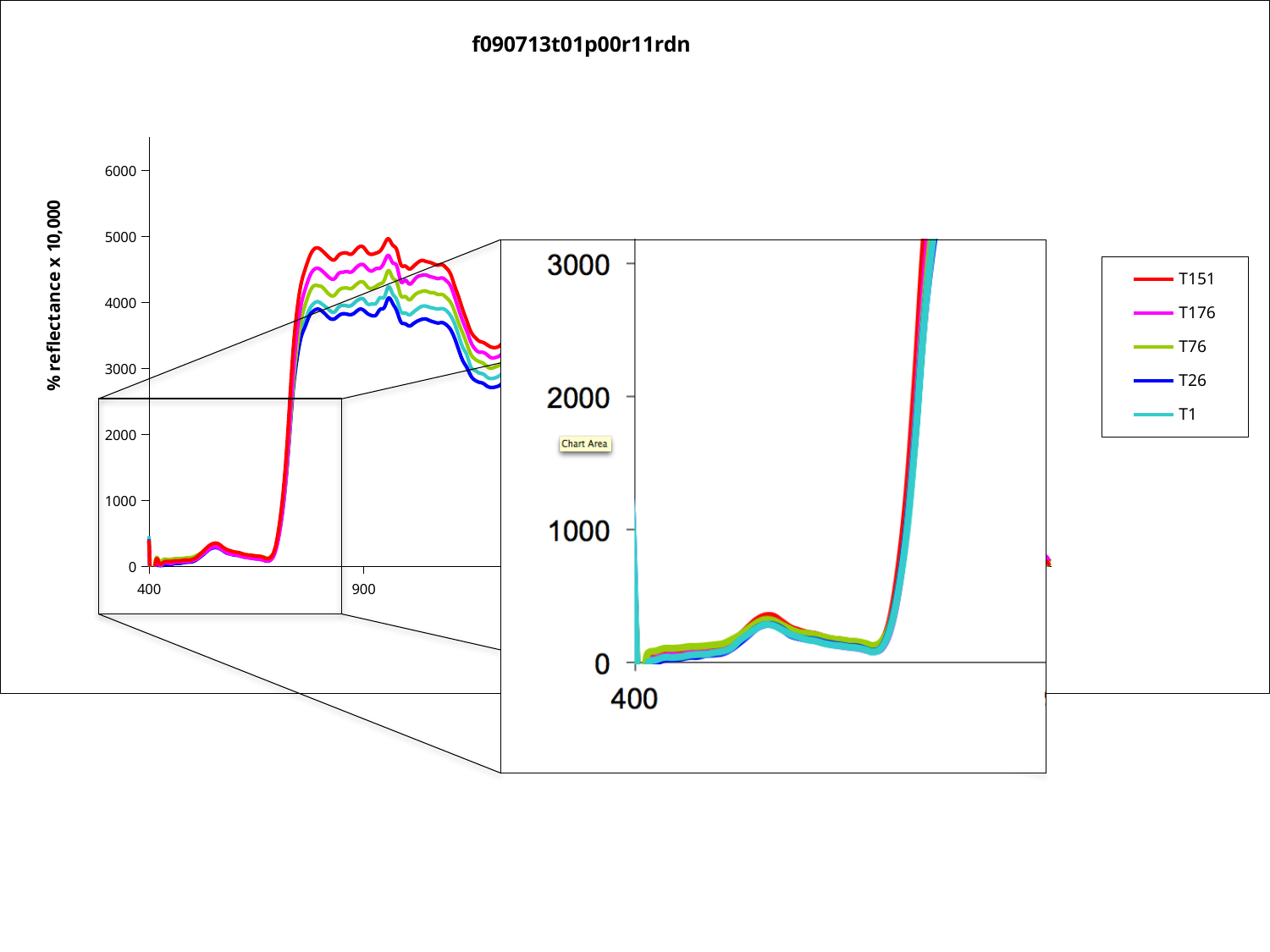
Which series has the lowest reflectance values in the plateau region beyond 900? T26 What is the title of the chart? f090713t01p00r11rdn Is the peak value for T151 greater or less than 4000? greater How many series does the legend list? 5 Is the peak value for T26 greater or less than 5000? less Which series has higher values in the plateau region, T151 or T26? T151 Do the reflectance values rise or fall between 400 and 900 on the x axis? rise Which series reaches the highest reflectance values in the plateau region beyond 900? T151 What kind of chart is shown on the slide? line chart What is the label of the y axis? % reflectance x 10,000 Which series has higher values in the plateau region, T176 or T1? T176